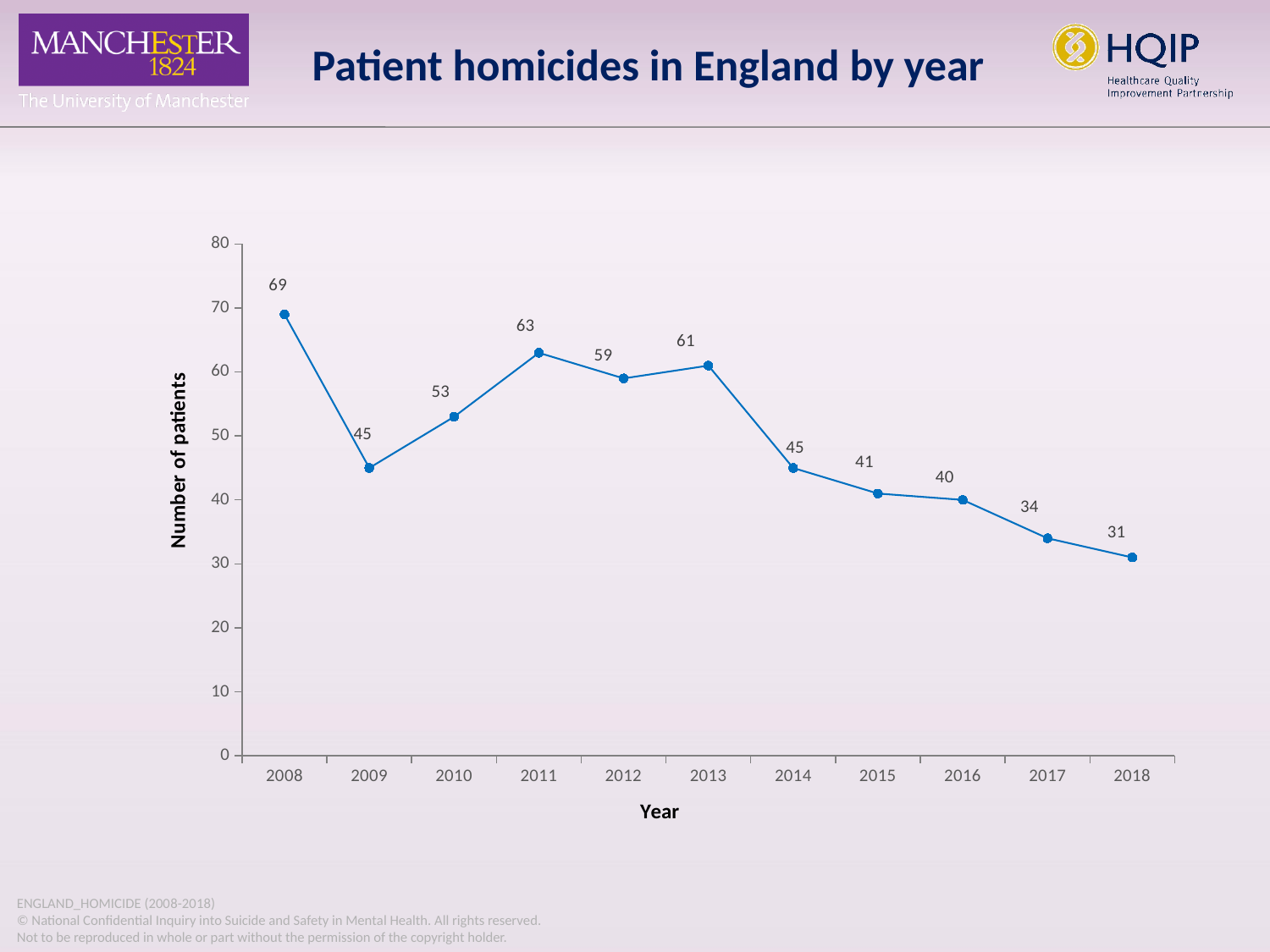
What is the number of patients in 2013? 61 Which year has the lowest number of patients? 2018 What is the number of patients in 2008? 69 Is the value for 2016 greater or less than 50? less What is the label of the y axis? Number of patients Which year has more patients, 2010 or 2014? 2010 How many years are plotted on the chart? 11 Which year has the highest number of patients? 2008 What kind of chart is shown on the slide? Line chart What is the number of patients in 2018? 31 What is the difference in the number of patients between 2011 and 2012? 4 What is the difference in the number of patients between 2008 and 2018? 38